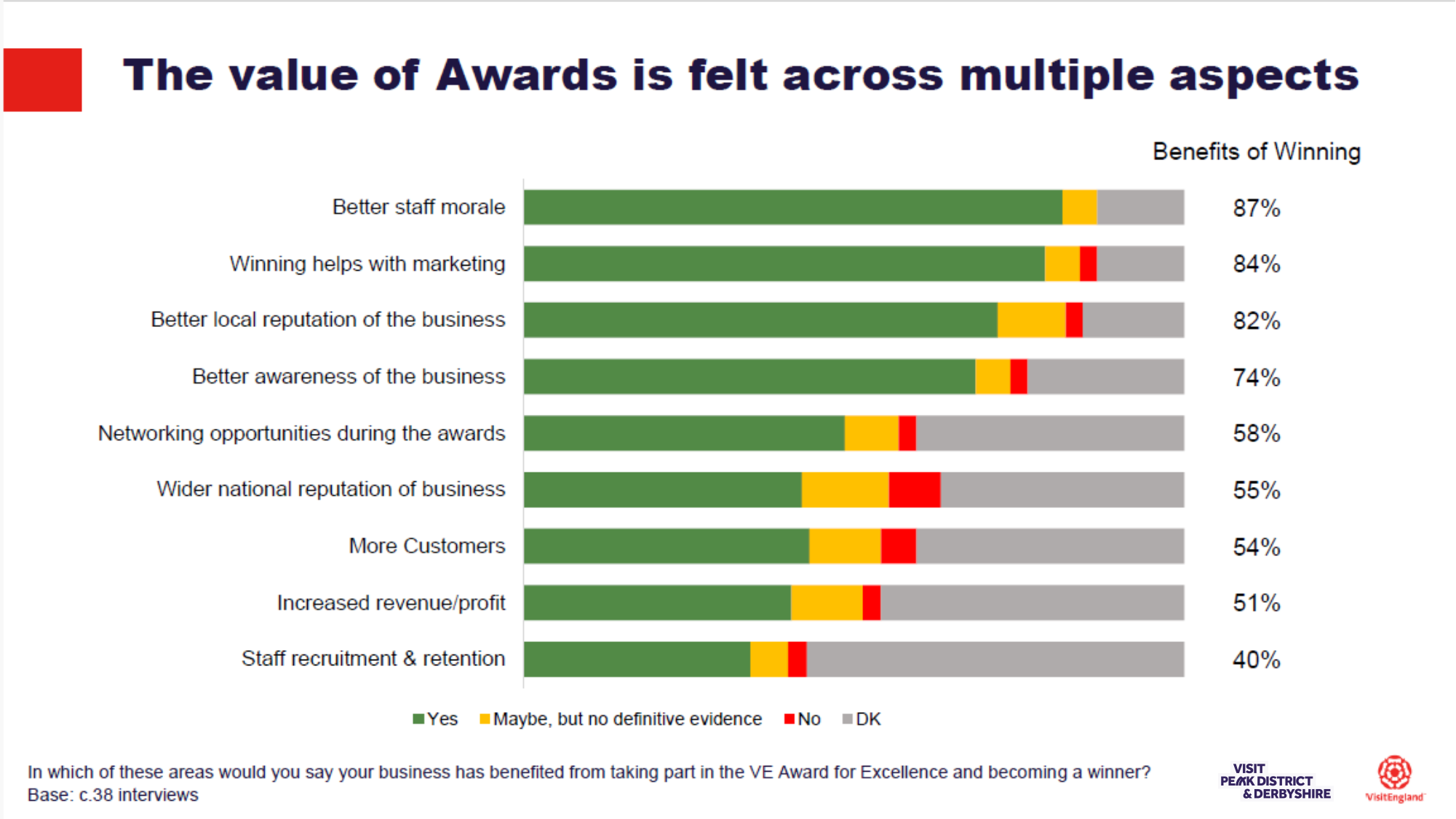
Which category has the highest Benefits of Winning percentage? Better staff morale How many series does the legend list? 4 What is the Benefits of Winning percentage shown for Staff recruitment & retention? 40% Which category has a larger 'No' segment: Wider national reputation of business or Better staff morale? Wider national reputation of business What is the difference between the Benefits of Winning percentages for Better staff morale and Staff recruitment & retention? 47 percentage points How many categories (bars) are shown in the chart? 9 What kind of chart is shown on the slide? Stacked horizontal bar chart What is the Benefits of Winning percentage shown for Better staff morale? 87% Do the Benefits of Winning percentages increase or decrease going from the top bar to the bottom bar? Decrease Which has a higher Benefits of Winning percentage: Networking opportunities during the awards or More Customers? Networking opportunities during the awards Which category has the lowest Benefits of Winning percentage? Staff recruitment & retention What is the Benefits of Winning percentage shown for Wider national reputation of business? 55%